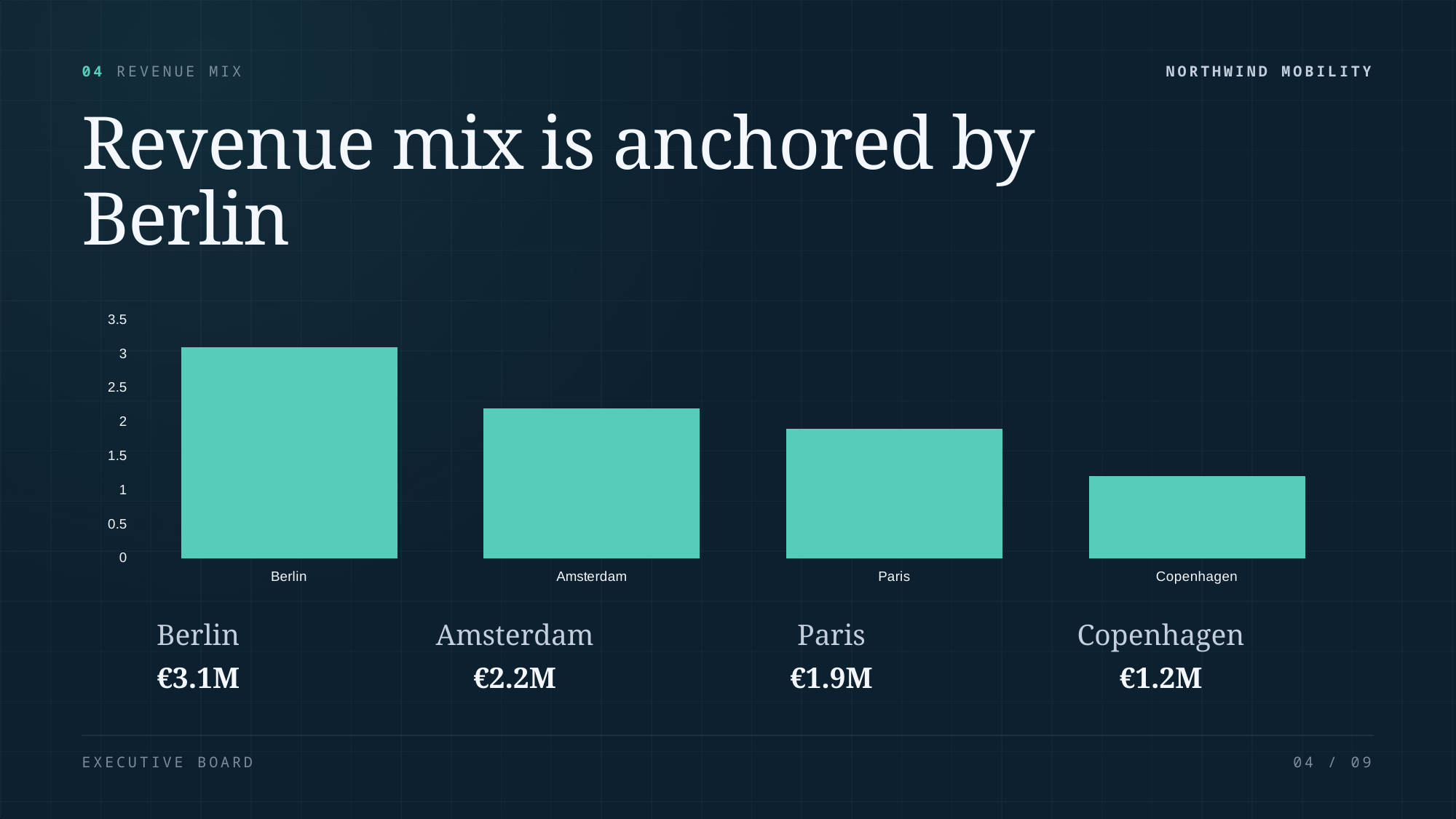
What is the difference between Berlin's and Copenhagen's revenue? €1.9M Is the value for Berlin greater or less than 3? greater What is the revenue value shown for Paris? €1.9M What is the revenue value shown for Copenhagen? €1.2M Do the bar values rise or fall from left to right across the x axis? Fall Which city has the lowest revenue? Copenhagen What is the revenue value shown for Berlin? €3.1M Which has higher revenue, Amsterdam or Paris? Amsterdam What kind of chart is shown on the slide? Bar chart What is the revenue value shown for Amsterdam? €2.2M Which city has the highest revenue? Berlin How many cities are shown in the chart? 4